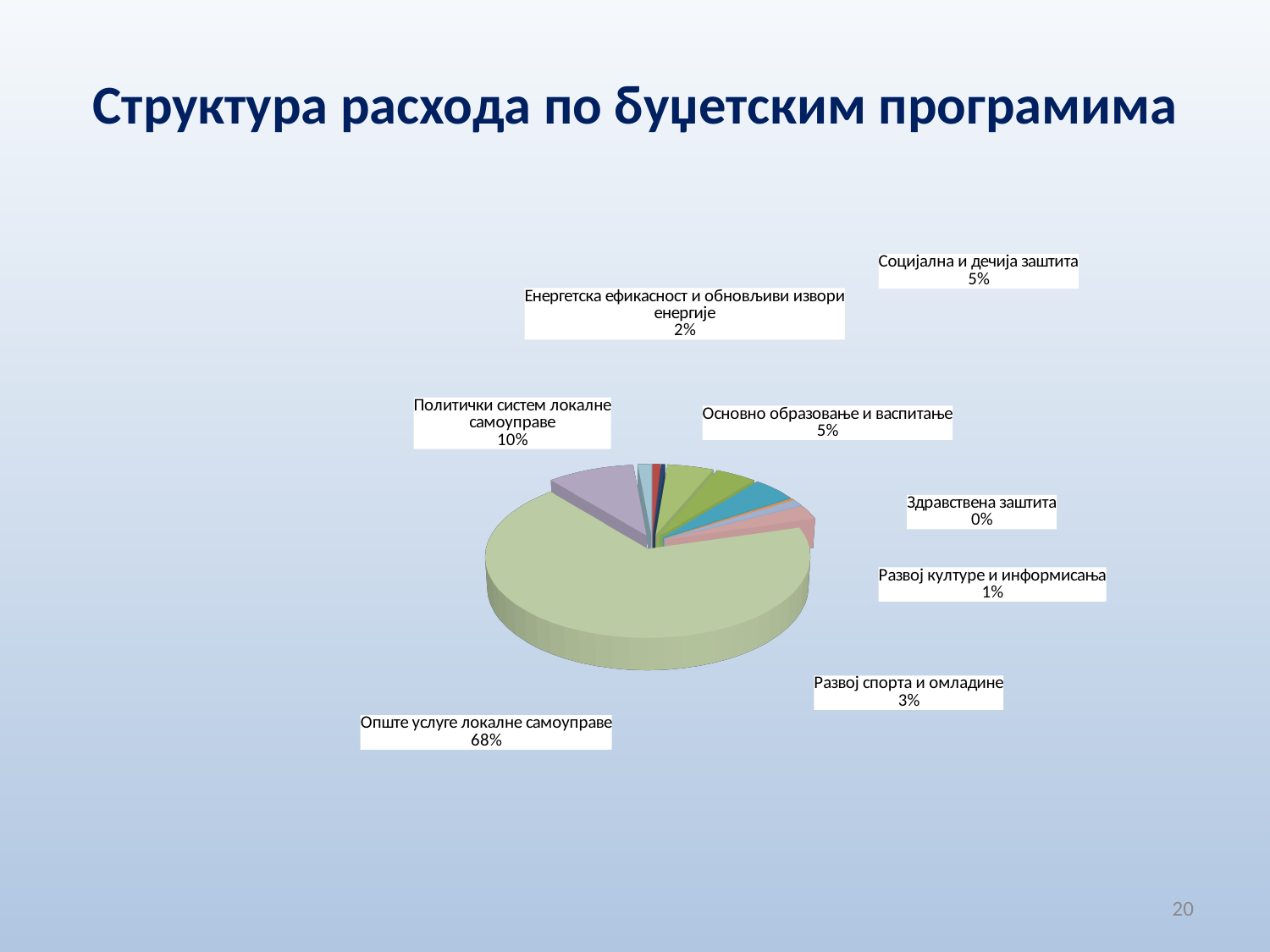
What percentage is shown for Енергетска ефикасност и обновљиви извори енергије? 2% What share of expenditure goes to Политички систем локалне самоуправе? 10% What percentage is shown for Здравствена заштита? 0% Which has a larger share: Развој спорта и омладине or Развој културе и информисања? Развој спорта и омладине Which labelled budget programme has the smallest share of expenditure? Здравствена заштита What percentage is shown for Развој спорта и омладине? 3% By how many percentage points does Опште услуге локалне самоуправе exceed Политички систем локалне самоуправе? 58 percentage points What percentage is shown for Социјална и дечија заштита? 5% Which budget programme has the largest share of expenditure? Опште услуге локалне самоуправе What share of expenditure goes to Опште услуге локалне самоуправе? 68% What is the title of the slide? Структура расхода по буџетским програмима What kind of chart is shown on the slide? pie chart